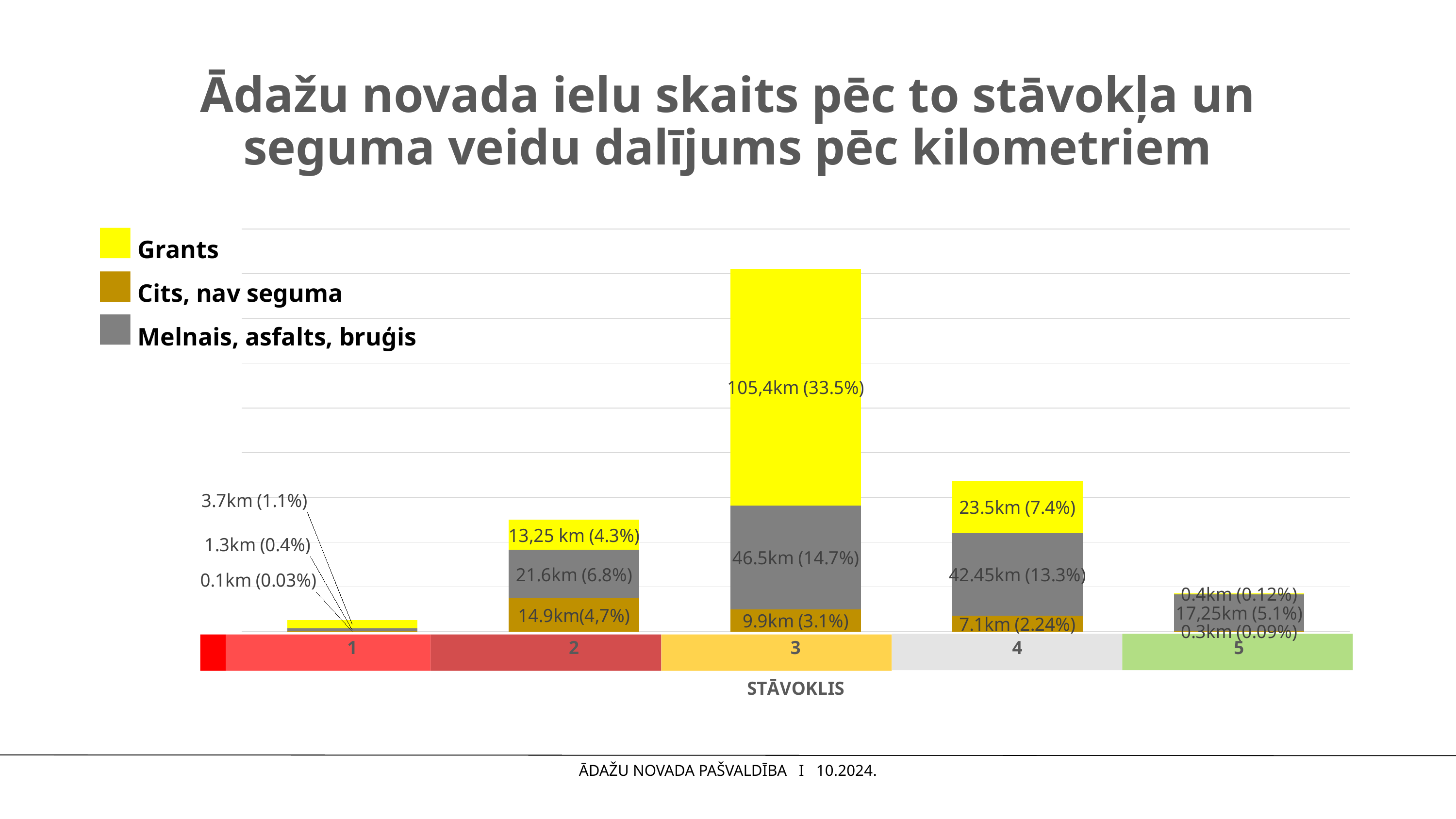
What type of chart is shown on the slide? Stacked bar chart How many series does the legend list? 3 What is the difference in kilometres between the Grants value for category 4 and for category 2? 10.25 km What is the Cits, nav seguma value for category 2? 14.9km(4,7%) What is the total length in kilometres of the stacked bar for category 2? 49.75 km What is the Melnais, asfalts, bruģis value for category 5? 17,25km (5.1%) What is the Grants value for category 3? 105,4km (33.5%) What is the Melnais, asfalts, bruģis value for category 4? 42.45km (13.3%) Which category has the smallest total stacked bar? 1 Which is larger, the Melnais, asfalts, bruģis value for category 3 or for category 4? Category 3 Which category has the largest Grants segment? 3 How many categories (stāvoklis values) are shown on the x axis? 5